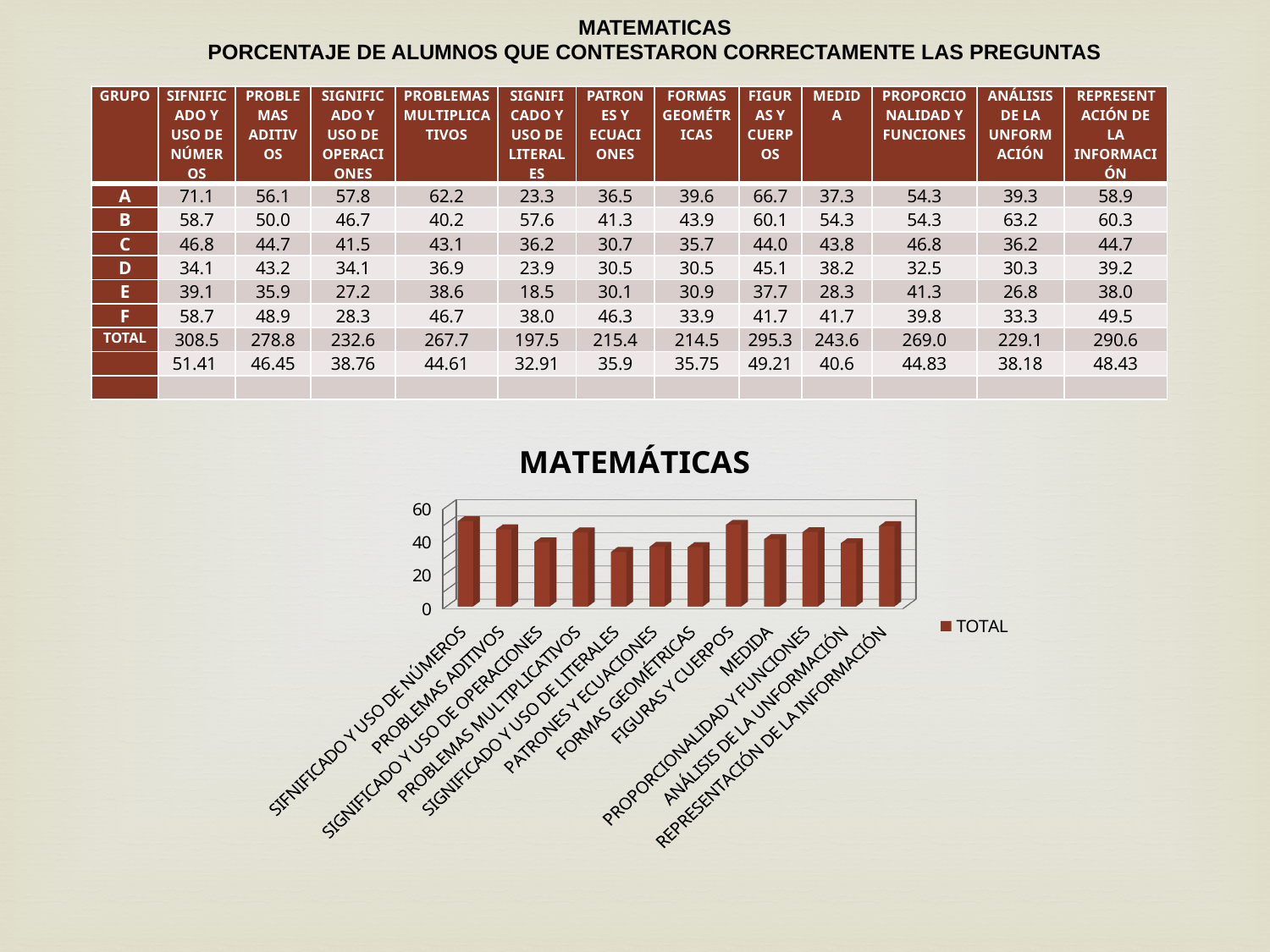
What type of chart is shown on the slide? Bar chart How many categories are plotted along the x axis of the chart? 12 What is the title of the chart? MATEMÁTICAS Is the value for FIGURAS Y CUERPOS greater or less than 40? greater How many series does the chart legend list? 1 Which category has the lowest bar in the chart? SIGNIFICADO Y USO DE LITERALES Is the value for PATRONES Y ECUACIONES greater or less than 40? less What is the name of the series shown in the chart legend? TOTAL Which category has the highest bar in the chart? SIFNIFICADO Y USO DE NÚMEROS Which is larger in the chart, the value for REPRESENTACIÓN DE LA INFORMACIÓN or the value for ANÁLISIS DE LA INFORMACIÓN? REPRESENTACIÓN DE LA INFORMACIÓN Is the value for SIGNIFICADO Y USO DE LITERALES greater or less than 40? less Which is larger in the chart, the value for SIFNIFICADO Y USO DE NÚMEROS or the value for SIGNIFICADO Y USO DE LITERALES? SIFNIFICADO Y USO DE NÚMEROS